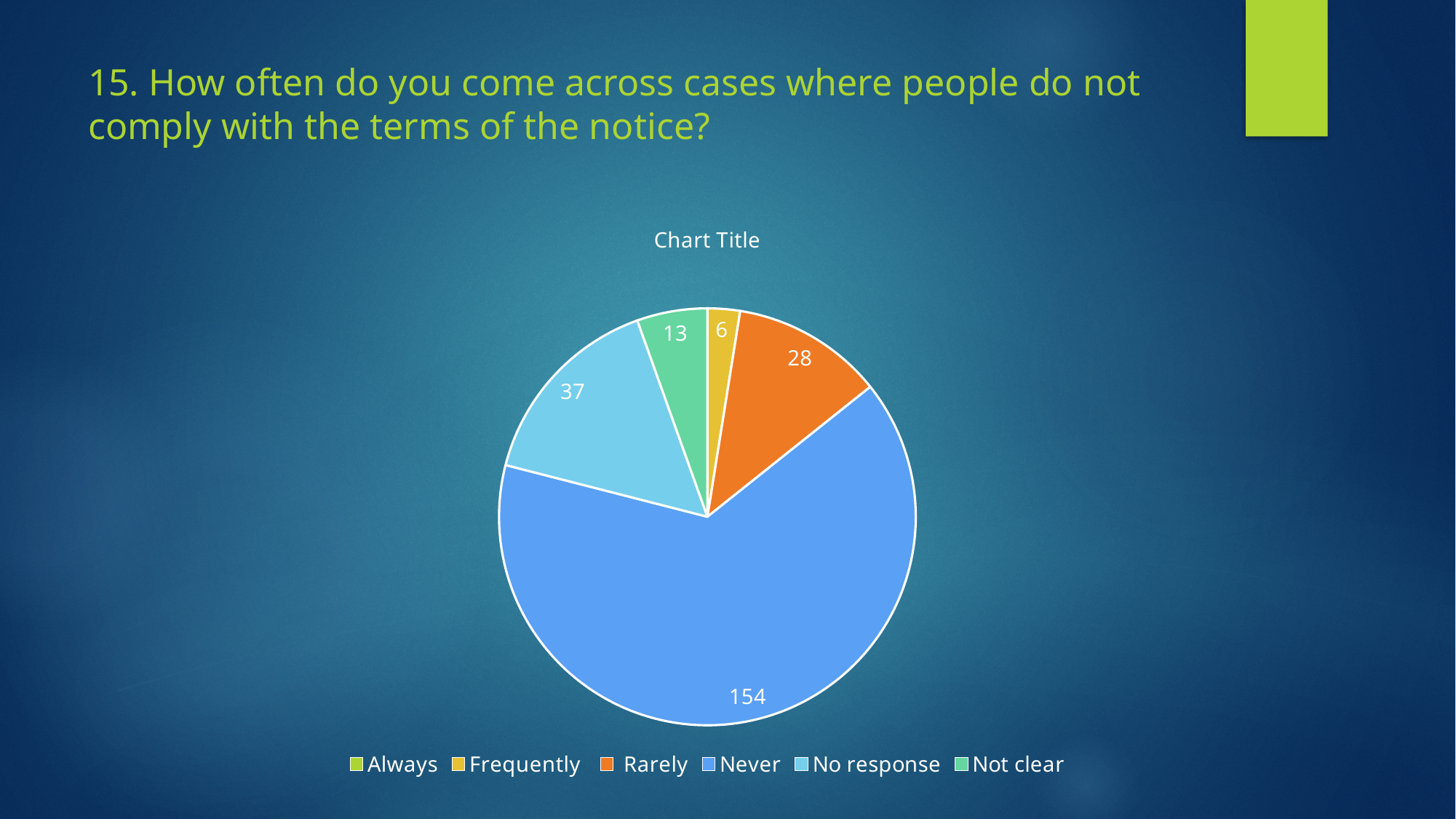
What value is shown for the Frequently slice? 6 What is the difference between the Rarely value and the Not clear value? 15 What value is shown for the No response slice? 37 Which category has the largest slice of the pie? Never What is the title printed above the chart? Chart Title What value is shown for the Never slice? 154 What value is shown for the Not clear slice? 13 How many entries does the legend list? 6 What value is shown for the Rarely slice? 28 What is the difference between the Never value and the No response value? 117 Which is larger, the No response slice or the Rarely slice? No response What kind of chart is shown on the slide? Pie chart